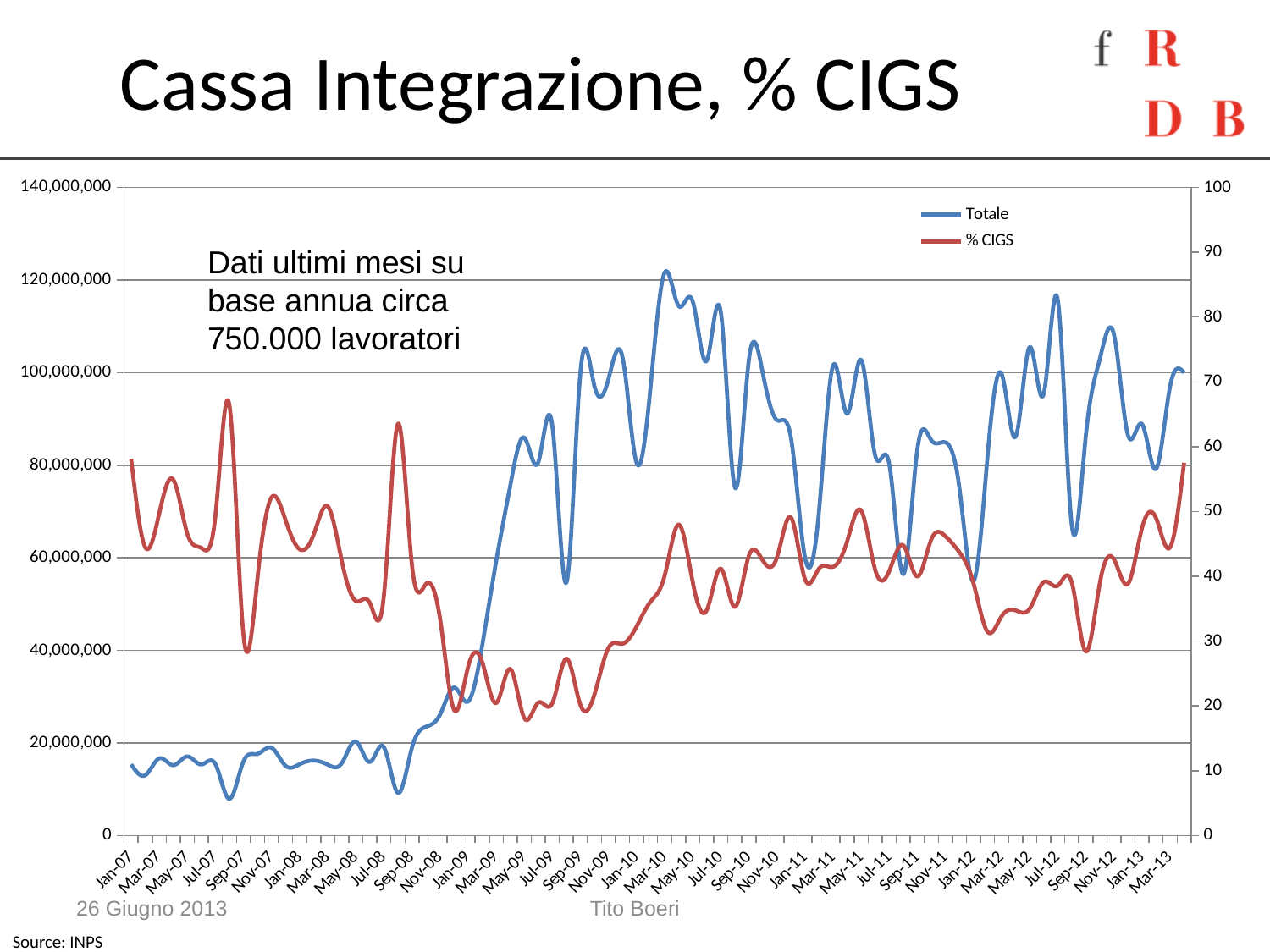
Is the value of Totale in Mar-10 greater or less than 100,000,000? greater What kind of chart is shown on the slide? line chart Is the value of % CIGS in May-09 greater or less than 30? less What are the two series named in the legend? Totale and % CIGS Which is larger for the Totale series: the value in Jan-07 or the value in Mar-10? Mar-10 How many series does the legend list? 2 Does the % CIGS series rise or fall between Jan-07 and Jan-09? fall Is the value of % CIGS in Jan-07 greater or less than 50? greater What colour is the line for the Totale series? blue Does the Totale series rise or fall between Jan-07 and Mar-10? rise